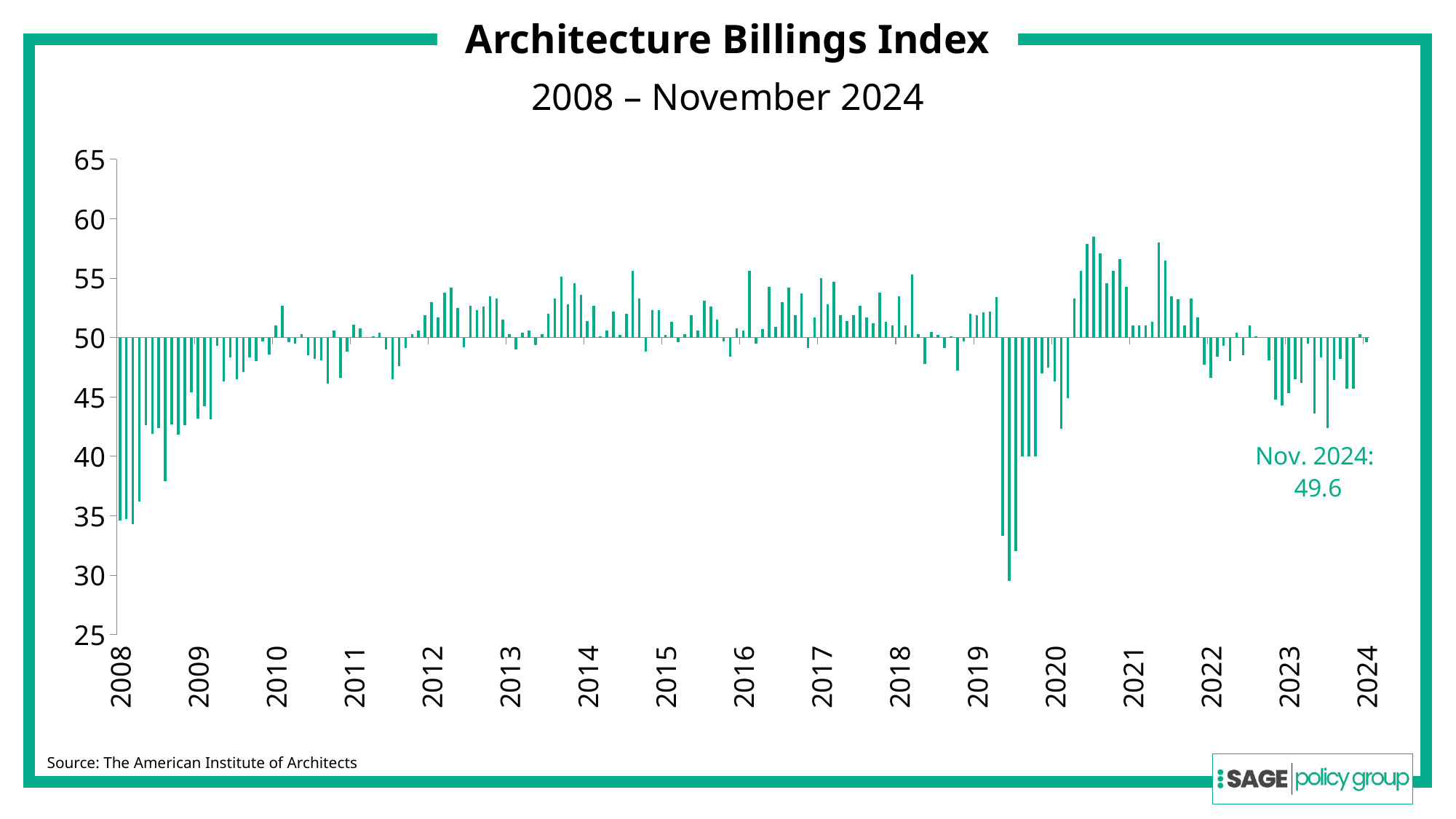
What is the value of the Architecture Billings Index for November 2024, as labeled on the chart? 49.6 What kind of chart is used to show the Architecture Billings Index? Bar chart Is the highest bar on the chart greater or less than 55? greater Is the lowest bar on the chart greater or less than 35? less What is the lowest value shown on the y-axis? 25 Is the deepest dip on the chart located at the left edge (2008) or near 2020? Near 2020 What is the title of the chart? Architecture Billings Index Is the labeled November 2024 value greater or less than 50? less What source is cited for the chart data? The American Institute of Architects